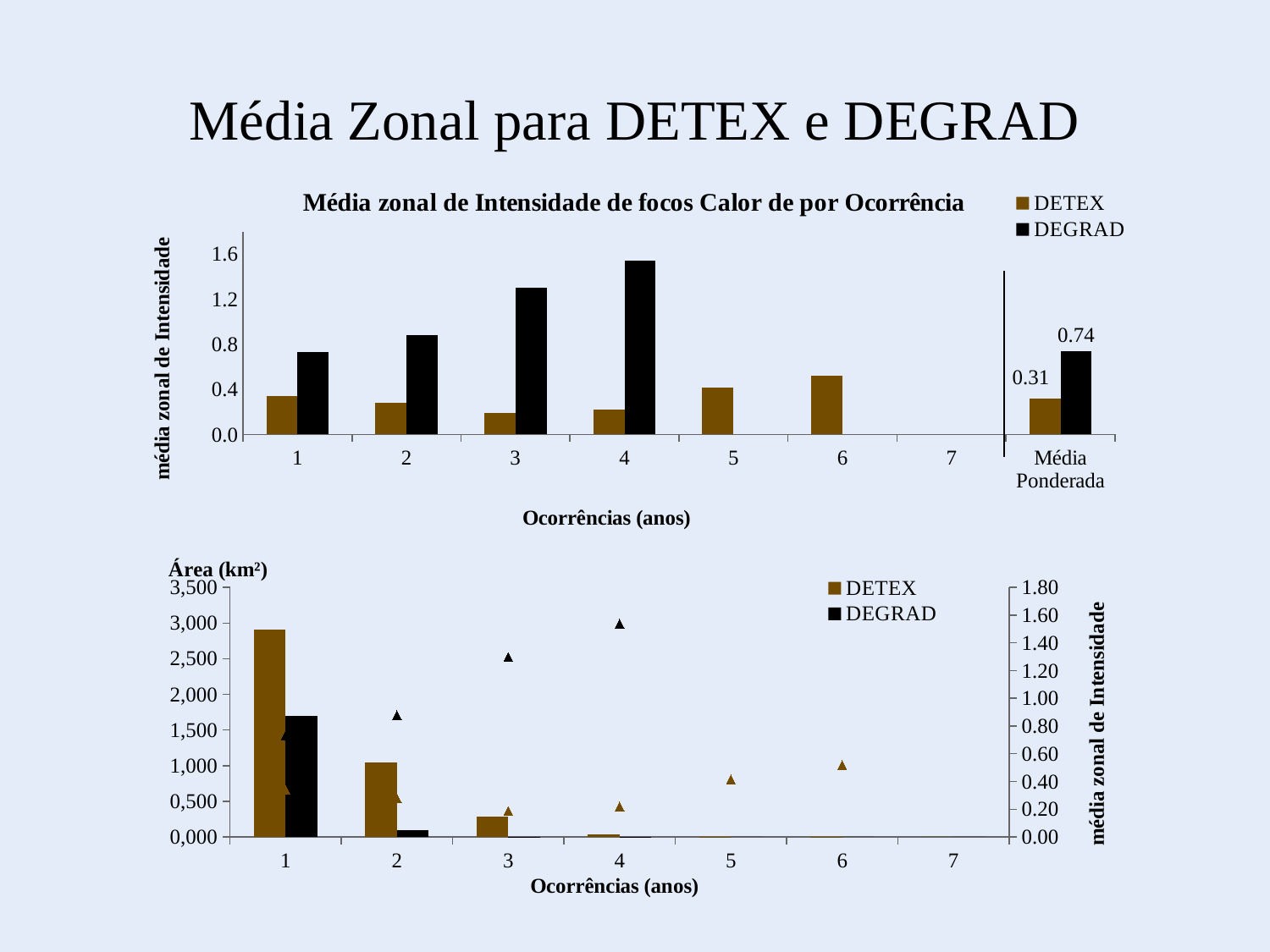
In the top chart, what is the DETEX value for Média Ponderada? 0.31 In the top chart, what is the difference between the DEGRAD and DETEX values for Média Ponderada? 0.43 In the bottom chart, is the DETEX area bar at occurrence 1 greater or less than 2,500? greater What kind of chart is the top chart? bar chart In the top chart, is the DETEX value at occurrence 3 greater or less than 0.4? less In the bottom chart, do the DETEX area bars rise or fall from occurrence 1 to occurrence 4? fall In the top chart, what is the DEGRAD value for Média Ponderada? 0.74 In the bottom chart, at which occurrence is the DETEX area bar highest? 1 In the top chart, which series has the larger value for Média Ponderada, DETEX or DEGRAD? DEGRAD In the top chart, at which occurrence (1 to 7) is the DEGRAD bar highest? 4 How many series does the legend of the top chart list? 2 In the top chart, is the DEGRAD value at occurrence 4 greater or less than 1.2? greater